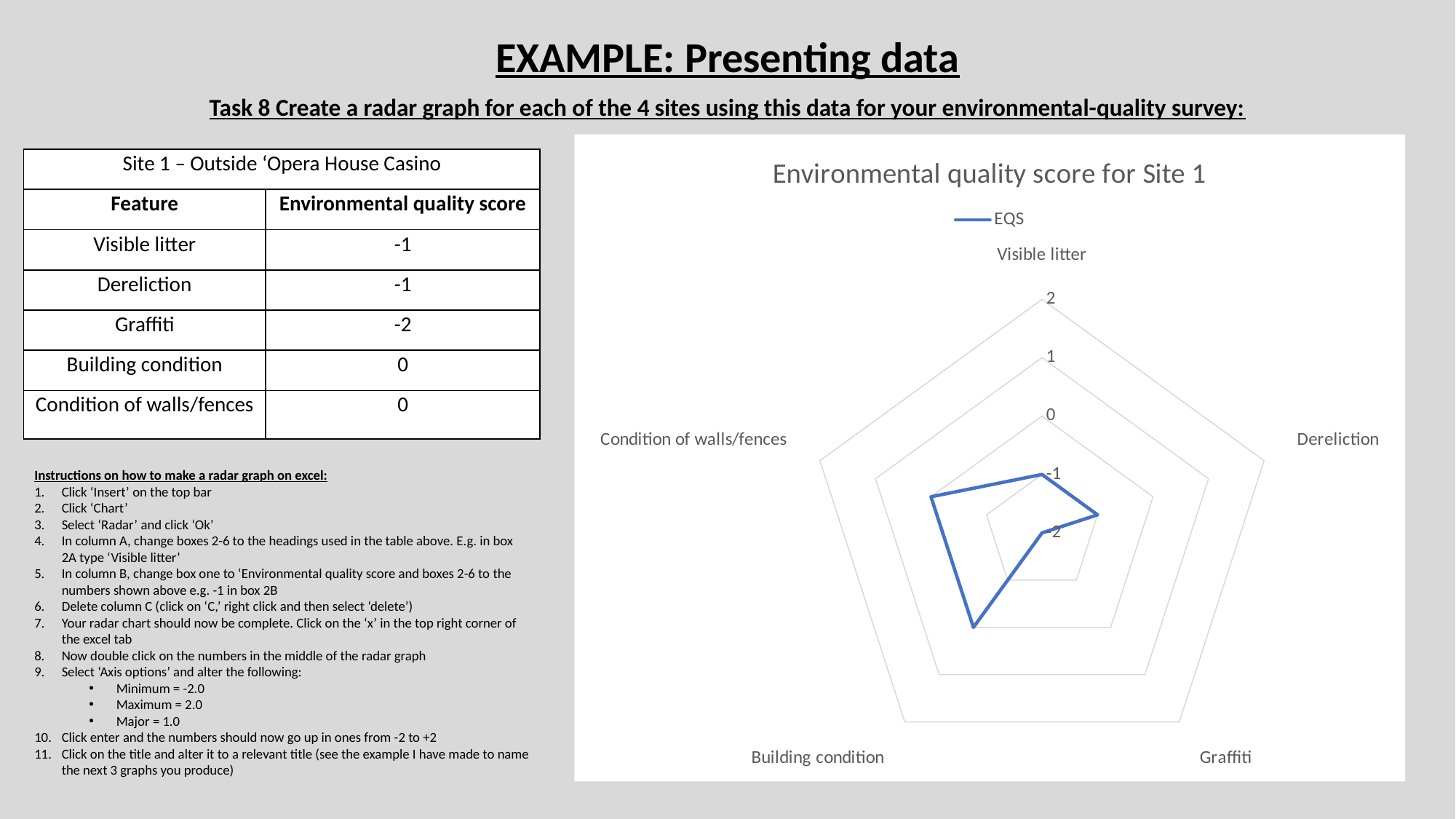
Which has the higher score, Visible litter or Graffiti? Visible litter What is the environmental quality score for Building condition? 0 What series name does the chart legend show? EQS What is the environmental quality score for Graffiti? -2 What is the environmental quality score for Visible litter? -1 What is the title of the chart? Environmental quality score for Site 1 What is the difference between the scores for Building condition and Graffiti? 2 Is the value for Dereliction greater or less than 0? less How many series does the legend list? 1 What kind of chart is shown on the slide? Radar chart Which feature has the lowest environmental quality score? Graffiti How many categories (axes) does the radar chart have? 5